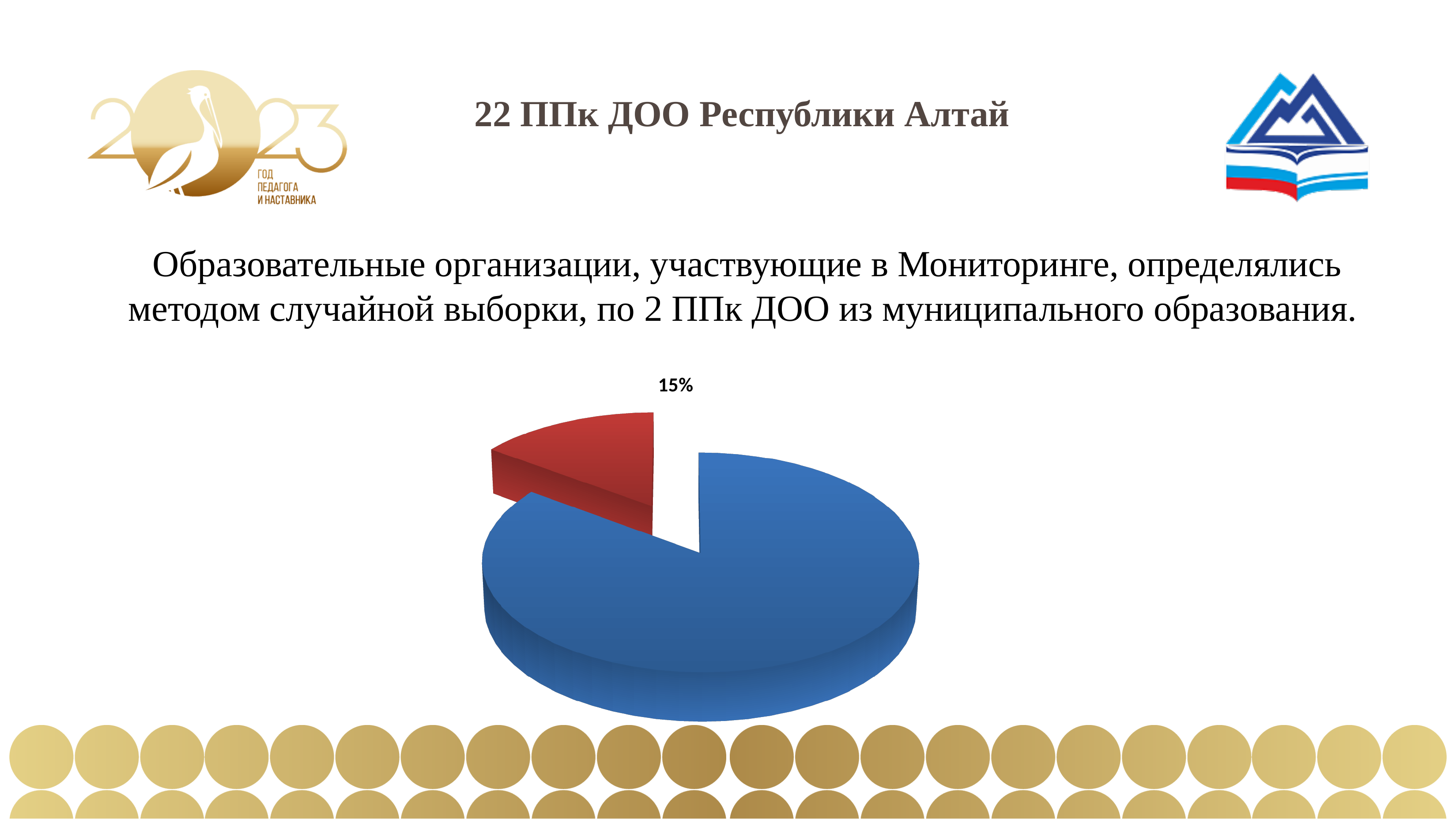
What percentage is printed on the red slice of the pie chart? 15% How many slices does the pie chart have? 2 Which slice of the pie chart is the smallest? the red slice What colours are the two slices of the pie chart? red and blue Which slice of the pie chart is pulled out (exploded) from the rest? the red slice What kind of chart is shown on the slide? pie chart What share of the pie does the red slice represent? 15% Which slice of the pie chart is the largest? the blue slice Which slice of the pie chart is larger, the red one or the blue one? the blue one